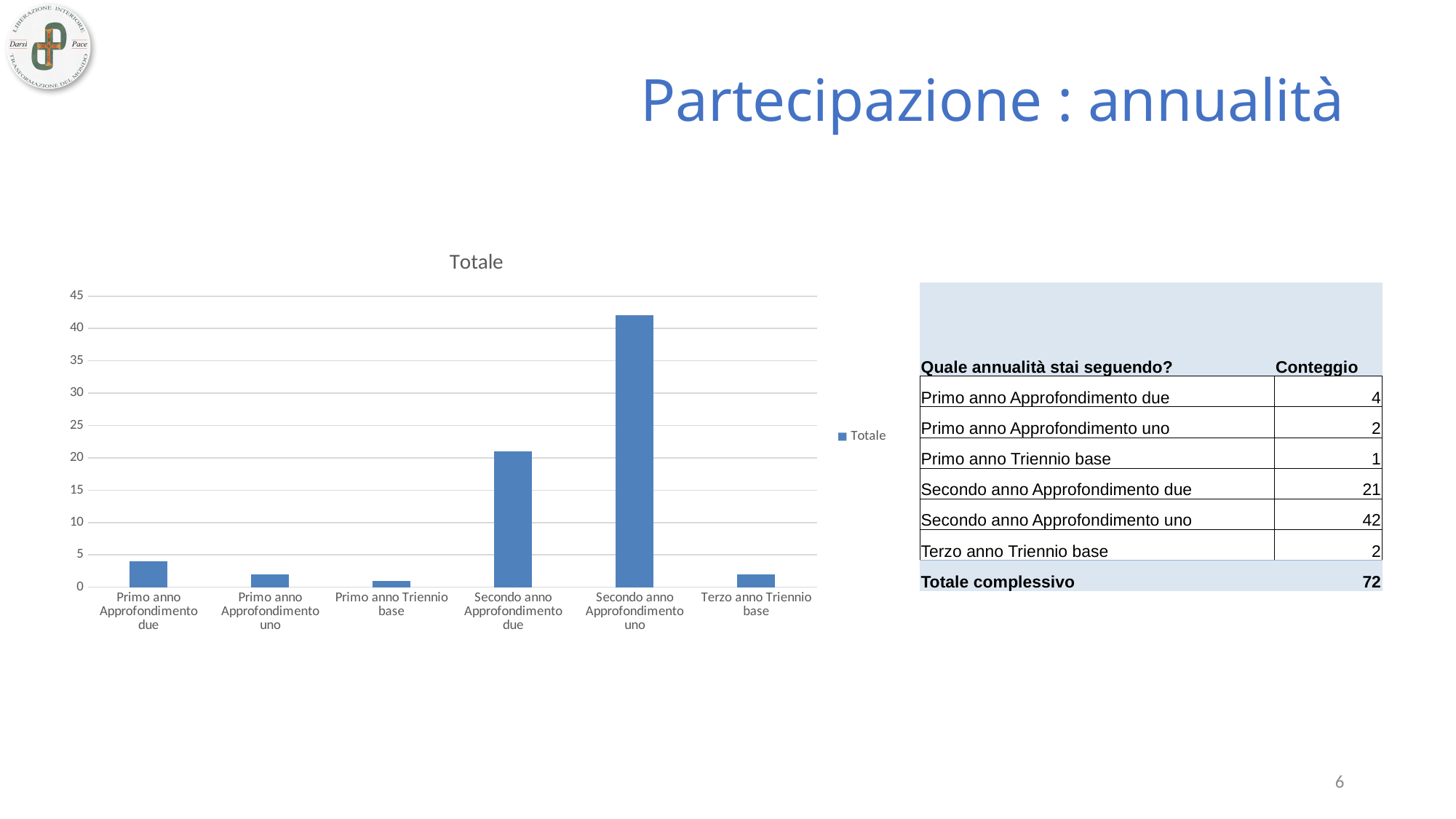
What is the value for Secondo anno Approfondimento due, as printed in the table on the slide? 21 Is the value for Secondo anno Approfondimento uno greater or less than 40? greater How many series does the chart legend list? 1 What type of chart is shown on the slide? bar chart Is the value for Secondo anno Approfondimento due greater or less than 25? less Which category has the lowest bar in the chart? Primo anno Triennio base What is the title of the chart? Totale What is the value for Secondo anno Approfondimento uno, as printed in the table on the slide? 42 Using the values printed in the table, what is the difference between Secondo anno Approfondimento uno and Secondo anno Approfondimento due? 21 Which category has the highest bar in the chart? Secondo anno Approfondimento uno Which is larger, the value for Primo anno Approfondimento due or the value for Terzo anno Triennio base? Primo anno Approfondimento due How many categories are shown on the x axis of the chart? 6